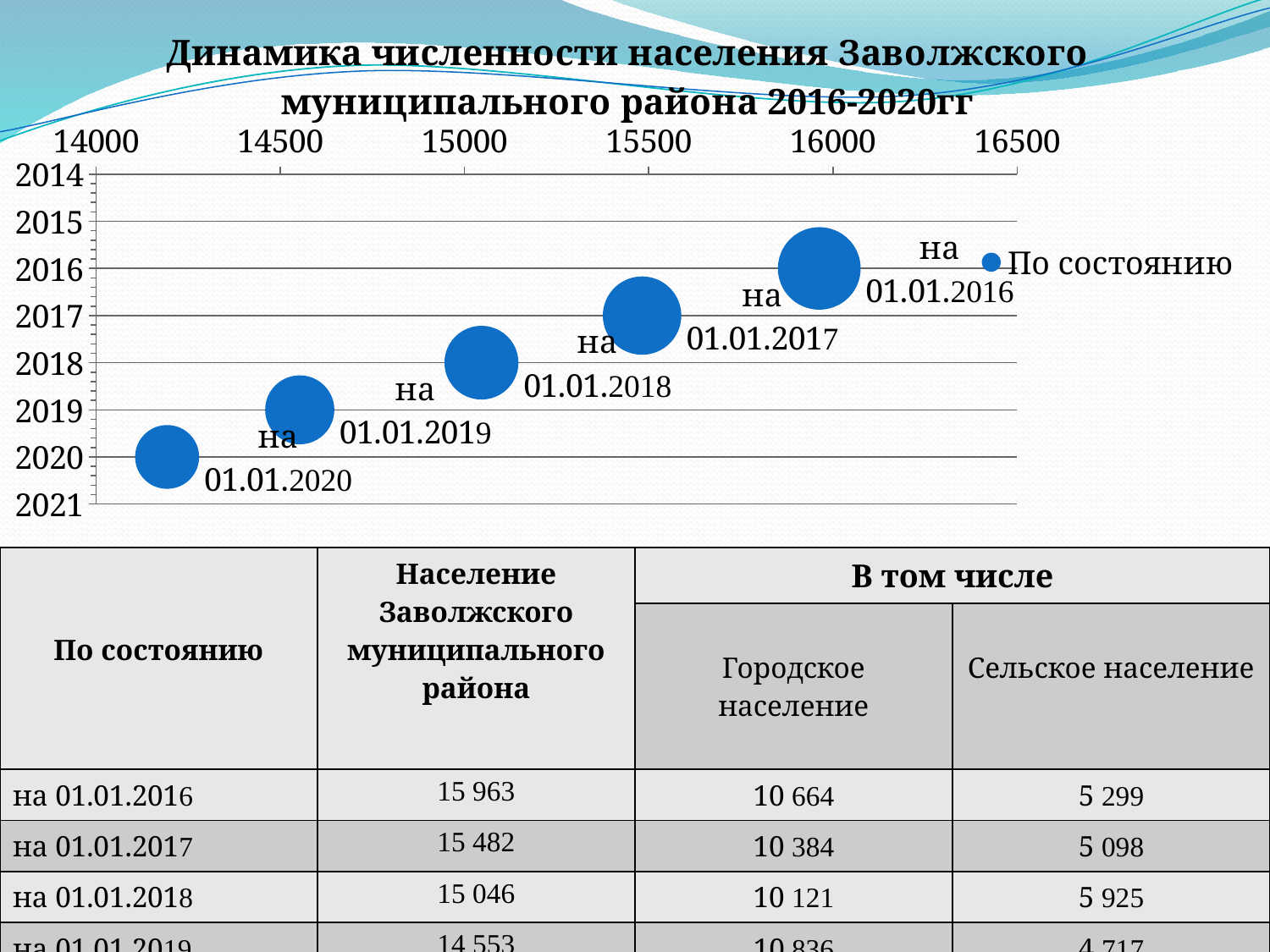
Is the value for на 01.01.2016 greater or less than 15500? greater What kind of chart is shown on the slide? bubble chart How many bubbles (data points) are plotted on the chart? 5 Do the population values rise or fall from 01.01.2016 to 01.01.2020? fall How many series does the chart legend list? 1 Is the value for на 01.01.2020 greater or less than 14500? less According to the table on the slide, what is the population of the Zavolzhsky municipal district на 01.01.2016? 15 963 What is the name of the series shown in the chart legend? По состоянию Which date has the bubble furthest to the right (the highest population) on the chart? на 01.01.2016 Which is larger, the value for на 01.01.2016 or the value for на 01.01.2020? на 01.01.2016 Is the value for на 01.01.2018 greater or less than 15500? less Which date has the bubble furthest to the left (the lowest population) on the chart? на 01.01.2020